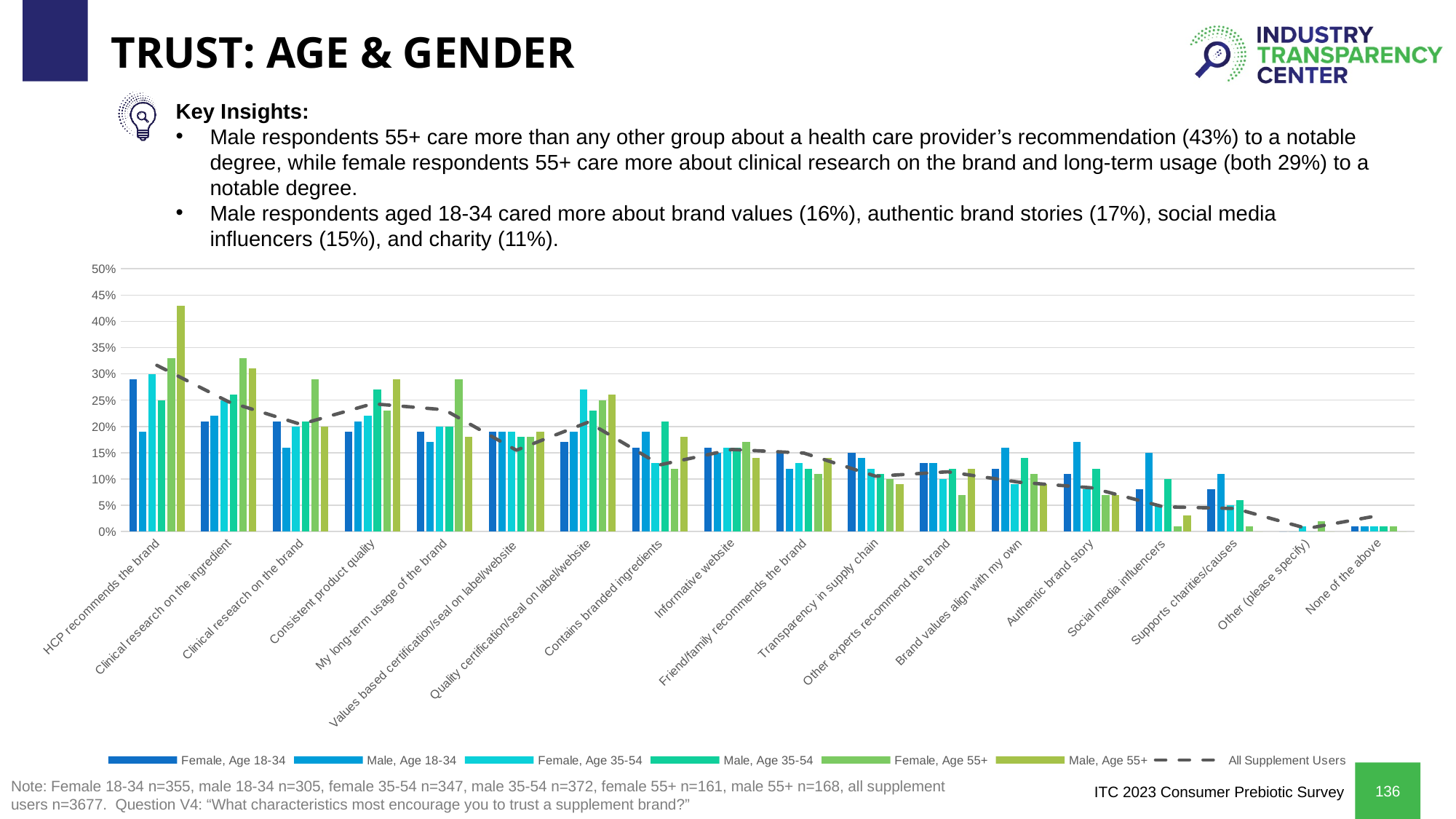
For 'HCP recommends the brand', which is larger: Male, Age 55+ or Female, Age 18-34? Male, Age 55+ Is the value for Male, Age 18-34 on 'Social media influencers' greater or less than 10%? greater How many categories are shown along the x axis of the chart? 18 Is the value for Male, Age 55+ on 'HCP recommends the brand' greater or less than 40%? greater Which series has the highest bar for 'HCP recommends the brand'? Male, Age 55+ Is the value for Male, Age 55+ on 'Social media influencers' greater or less than 5%? less Which category contains the tallest bar in the chart? HCP recommends the brand What kind of chart is shown on the slide? combination bar and line chart Which series is represented by the dashed line in the chart? All Supplement Users Do the values of the dashed 'All Supplement Users' line generally rise or fall from left to right along the x axis? fall How many series does the chart legend list? 7